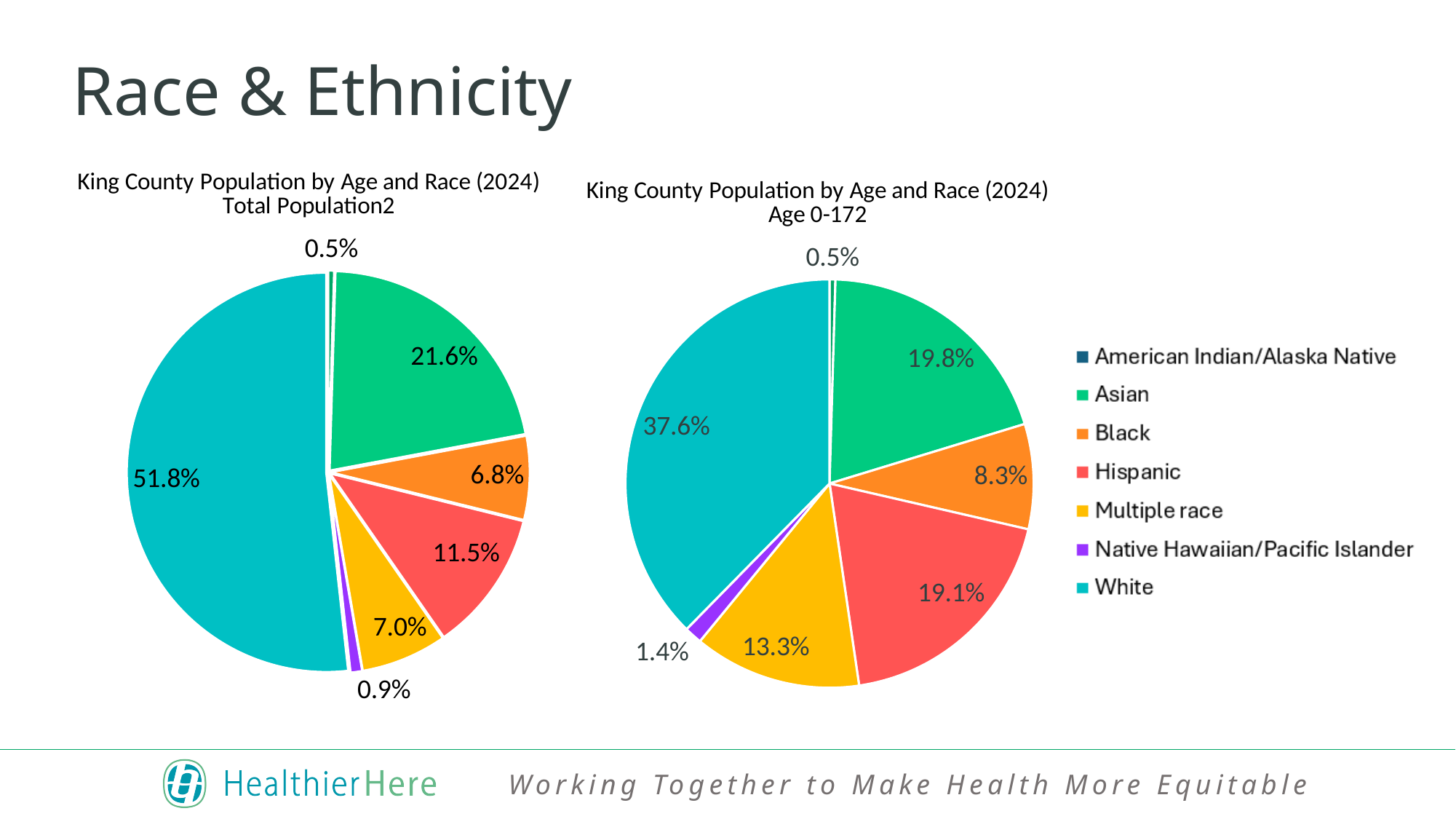
In the Total Population chart, what share of the population is White? 51.8% In the Age 0-17 chart, what share of the population is Multiple race? 13.3% How many race/ethnicity groups does the legend list? 7 In the Total Population chart, which race/ethnicity group has the smallest share? American Indian/Alaska Native What type of chart is used on this slide? Pie chart In the Age 0-17 chart, what share of the population is Native Hawaiian/Pacific Islander? 1.4% In the Total Population chart, what share of the population is Asian? 21.6% In the Age 0-17 chart, which is larger: the Asian share or the Hispanic share? Asian What is the difference between the White share in the Total Population chart and the White share in the Age 0-17 chart? 14.2% In the Age 0-17 chart, what share of the population is Hispanic? 19.1% In the Total Population chart, what is the difference between the Hispanic share and the Black share? 4.7% In the Age 0-17 chart, which race/ethnicity group has the largest share? White